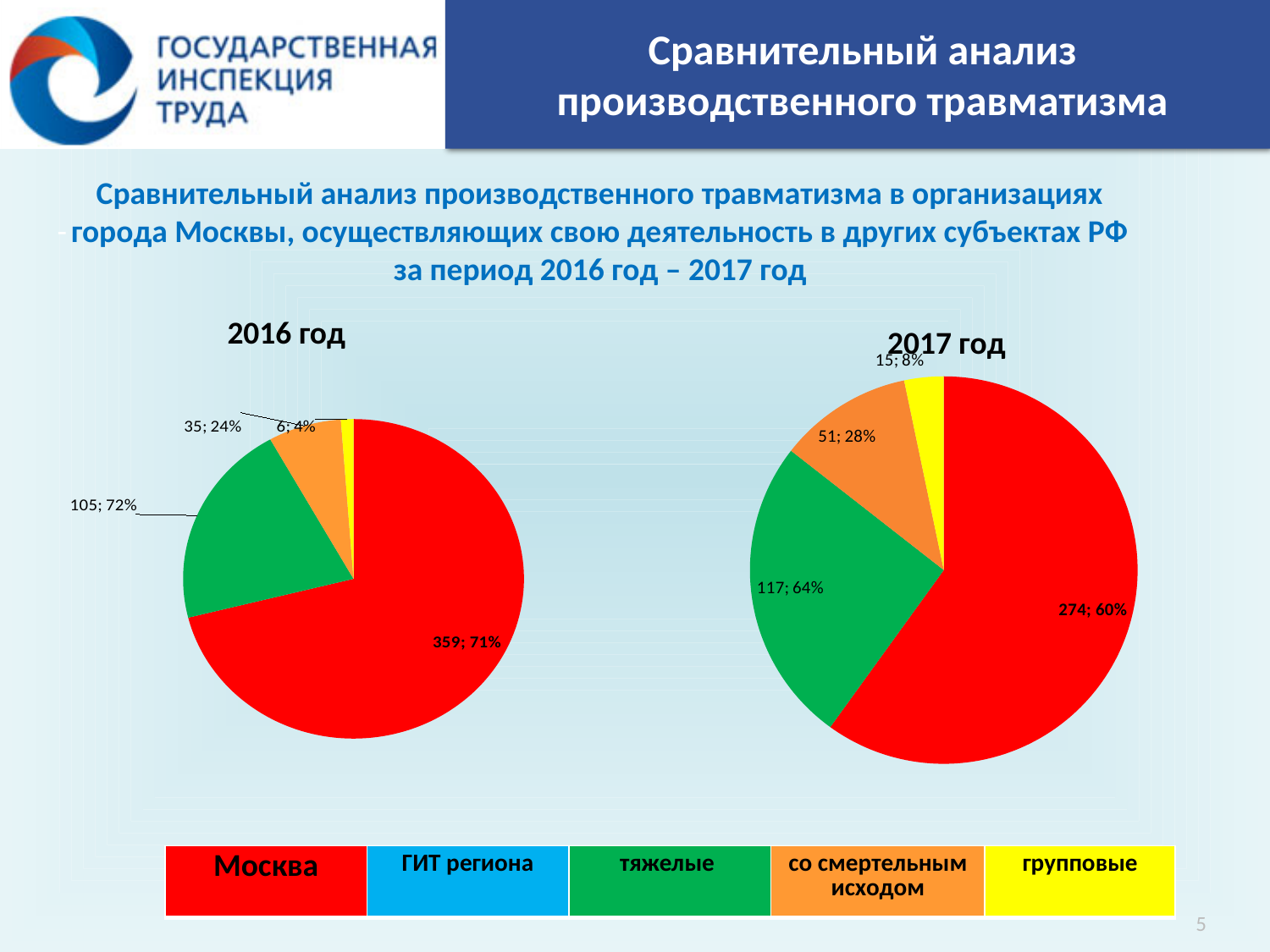
What type of charts are shown on the slide? Pie charts In the 2017 год pie chart, what is the data label on the green (тяжелые) slice? 117; 64% In the 2017 год pie chart, which slice is the largest? Москва (red) What is the difference between the Москва value in 2016 (359) and in 2017 (274)? 85 In the 2016 год pie chart, what is the data label on the yellow (групповые) slice? 6; 4% How many slices does the 2017 год pie chart have? 4 In the 2017 год pie chart, what is the data label on the orange (со смертельным исходом) slice? 51; 28% Which is larger: the тяжелые value in 2016 or in 2017? 2017 (117) In the 2016 год pie chart, which slice is the smallest? групповые (yellow) What is the difference between the групповые value in 2017 (15) and in 2016 (6)? 9 How many entries does the legend at the bottom of the slide list? 5 In the 2016 год pie chart, what is the data label on the red (Москва) slice? 359; 71%